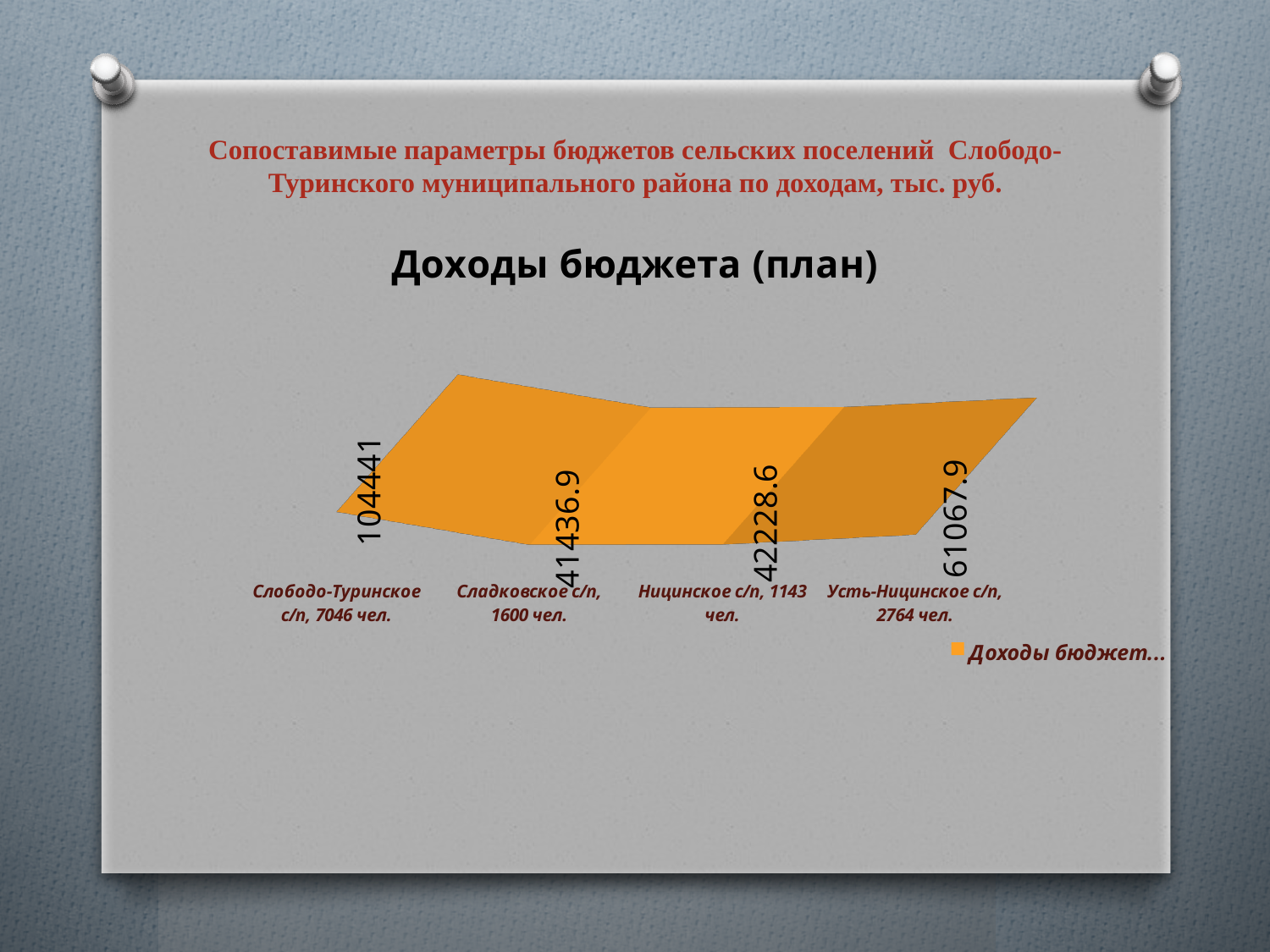
What is the value for Слободо-Туринское с/п? 104441 Which is larger, the value for Усть-Ницинское с/п or the value for Ницинское с/п? Усть-Ницинское с/п What kind of chart is this? 3D line chart What is the value for Сладковское с/п? 41436.9 What is the title of the chart? Доходы бюджета (план) What is the difference between the values for Слободо-Туринское с/п and Усть-Ницинское с/п? 43373.1 Which settlement has the highest planned budget income? Слободо-Туринское с/п What is the difference between the values for Ницинское с/п and Сладковское с/п? 791.7 What is the value for Усть-Ницинское с/п? 61067.9 Which settlement has the lowest planned budget income? Сладковское с/п How many settlements are shown on the chart? 4 What is the value for Ницинское с/п? 42228.6